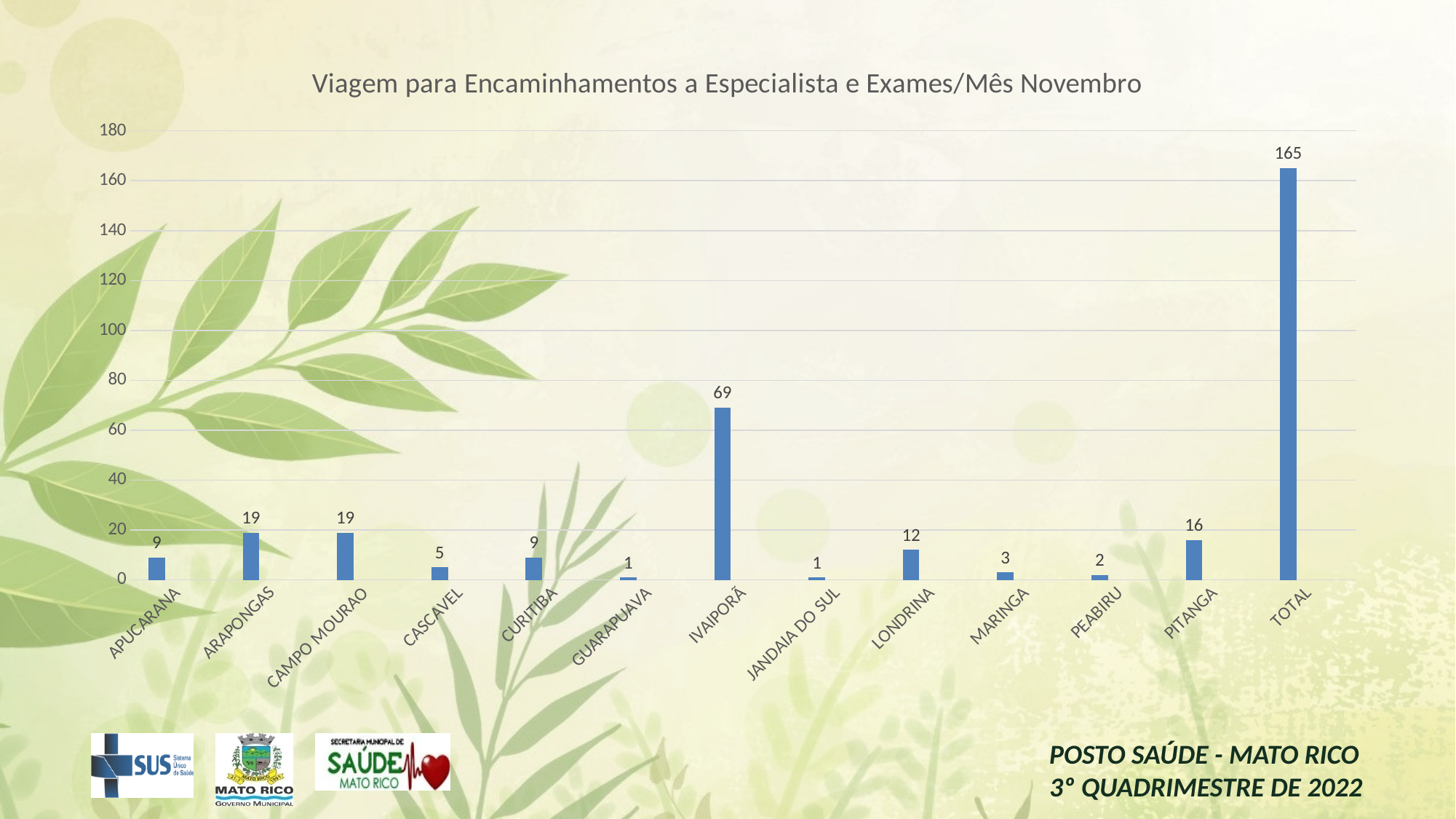
What kind of chart is shown on the slide? Bar chart Which city has the lowest value, CASCAVEL or MARINGA? MARINGA What is the value for LONDRINA? 12 Is the value for TOTAL greater or less than 160? greater What is the difference between the values for IVAIPORÃ and PITANGA? 53 What is the title of the chart? Viagem para Encaminhamentos a Especialista e Exames/Mês Novembro What is the value for IVAIPORÃ? 69 What is the value for PITANGA? 16 Excluding the TOTAL bar, which city has the highest value? IVAIPORÃ How many categories are shown on the x axis, including TOTAL? 13 What is the value shown for TOTAL? 165 What is the difference between the values for ARAPONGAS and APUCARANA? 10